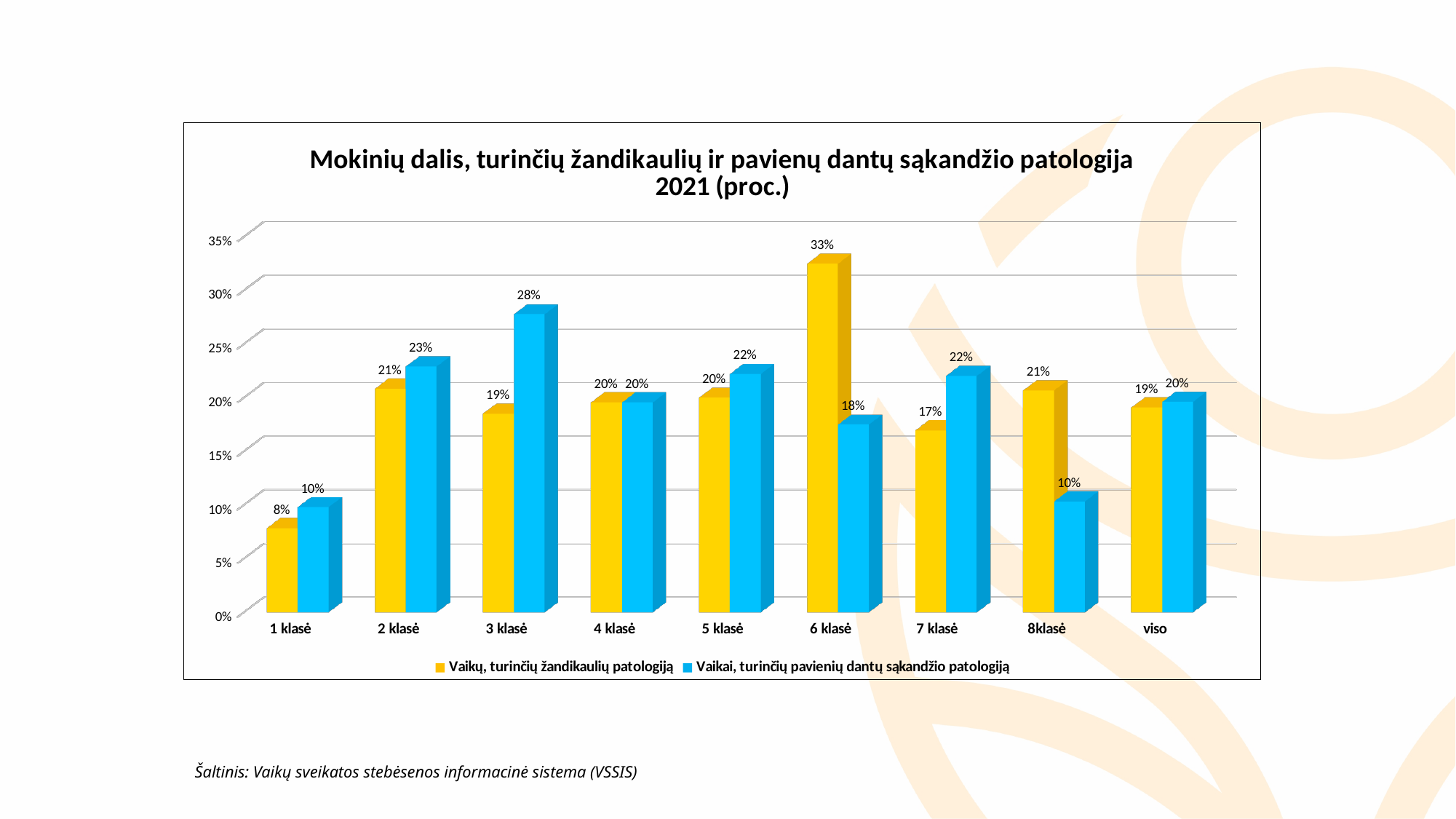
What type of chart is shown on the slide? bar chart What is the value for 'Vaikai, turinčių pavienių dantų sąkandžio patologiją' in 3 klasė? 28% What is the difference between the two series in 6 klasė? 15% How many series does the legend list? 2 Which category has the highest value for 'Vaikų, turinčių žandikaulių patologiją'? 6 klasė What is the value for 'Vaikų, turinčių žandikaulių patologiją' for 'viso'? 19% What is the difference between the 'Vaikai, turinčių pavienių dantų sąkandžio patologiją' values for 3 klasė and 8klasė? 18% How many categories are shown on the x axis? 9 What colour represents 'Vaikai, turinčių pavienių dantų sąkandžio patologiją' in the chart? blue What is the value for 'Vaikų, turinčių žandikaulių patologiją' in 6 klasė? 33% In 8klasė, which series has the larger value? Vaikų, turinčių žandikaulių patologiją Which category has the lowest value for 'Vaikų, turinčių žandikaulių patologiją'? 1 klasė